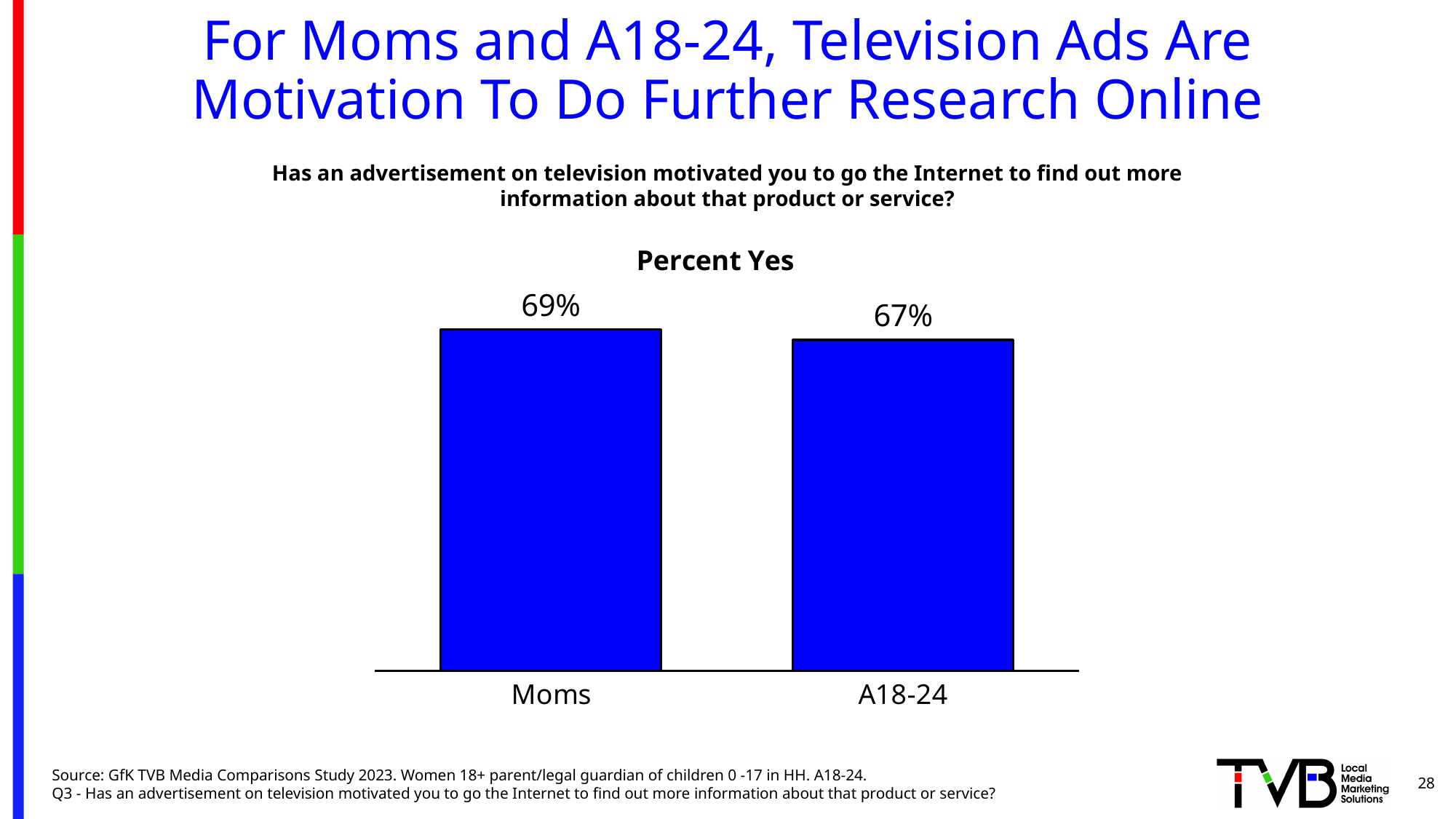
What colour are the bars in the chart? blue What kind of chart is shown on the slide? bar chart What is the Percent Yes value for Moms? 69% How many categories are shown in the chart? 2 What is the difference in percentage points between the Moms and A18-24 values? 2 percentage points What is the Percent Yes value for A18-24? 67% Which category has the higher Percent Yes value? Moms Which category has the lower Percent Yes value? A18-24 What is the title of the chart? Percent Yes Is the value for Moms larger or smaller than the value for A18-24? larger